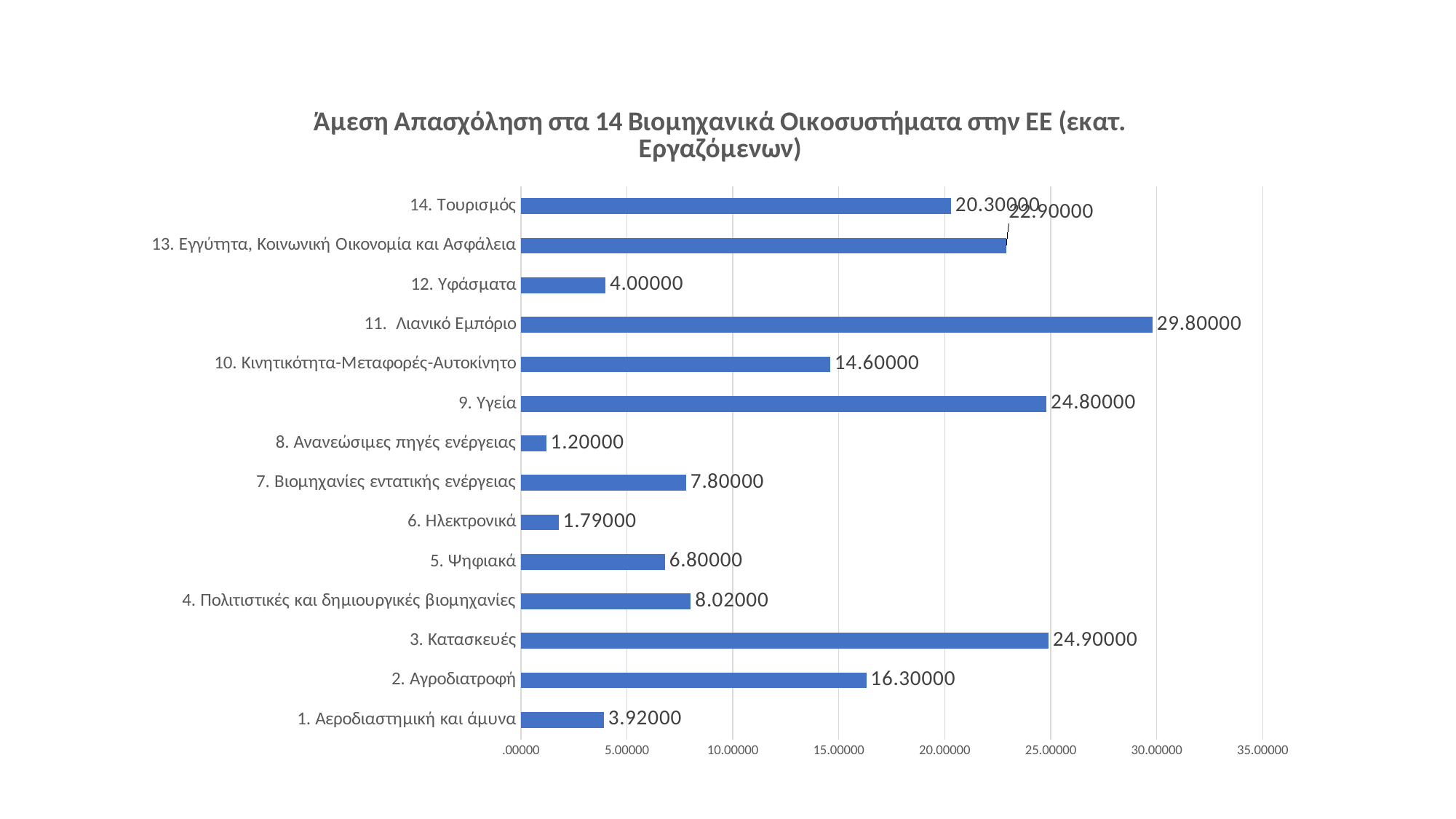
What is the value for 13. Εγγύτητα, Κοινωνική Οικονομία και Ασφάλεια? 22.90000 Which category has the highest value? 11. Λιανικό Εμπόριο What is the value for 6. Ηλεκτρονικά? 1.79000 What is the title of the chart? Άμεση Απασχόληση στα 14 Βιομηχανικά Οικοσυστήματα στην ΕΕ (εκατ. Εργαζόμενων) What is the value for 1. Αεροδιαστημική και άμυνα? 3.92000 What is the difference between the values for 11. Λιανικό Εμπόριο and 14. Τουρισμός? 9.50000 Which is larger, the value for 2. Αγροδιατροφή or the value for 10. Κινητικότητα-Μεταφορές-Αυτοκίνητο? 2. Αγροδιατροφή How many categories are shown in the chart? 14 Which category has the lowest value? 8. Ανανεώσιμες πηγές ενέργειας Is the value for 9. Υγεία greater or less than 20.00000? greater What is the value for 11. Λιανικό Εμπόριο? 29.80000 What kind of chart is shown on the slide? bar chart